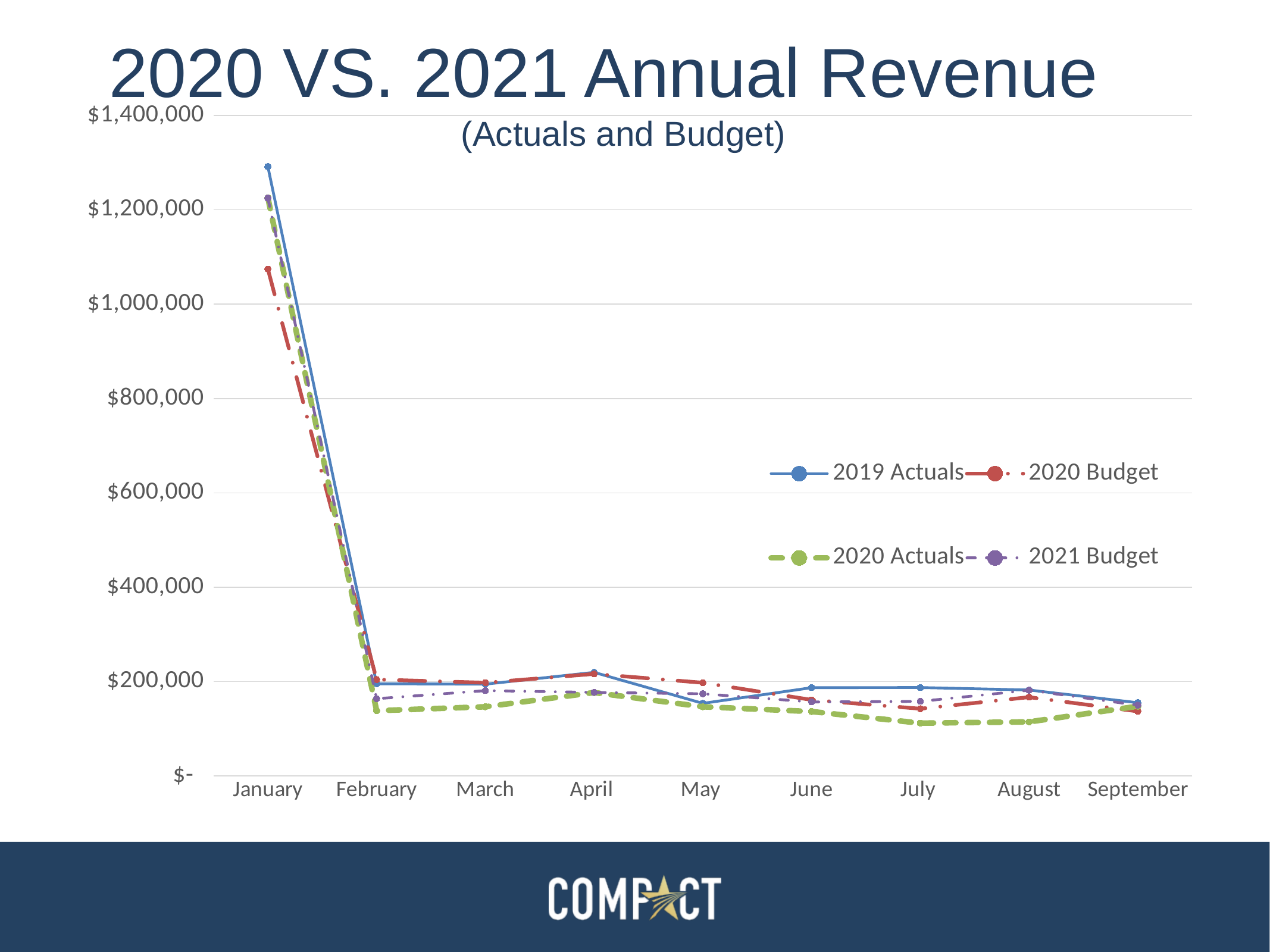
Is the value for 2020 Budget in January greater or less than $1,200,000? less Which month has the highest value for 2019 Actuals? January In January, which is larger: 2019 Actuals or 2020 Budget? 2019 Actuals Is the value for 2020 Actuals in July greater or less than $200,000? less What kind of chart is shown on the slide? Line chart How many months are shown on the x axis? 9 In July, which is larger: 2019 Actuals or 2020 Actuals? 2019 Actuals Do the values rise or fall from January to February? fall Which month has the highest value for 2020 Budget? January What is the subtitle shown under the chart title? (Actuals and Budget) How many series does the legend list? 4 Is the value for 2019 Actuals in January greater or less than $1,200,000? greater